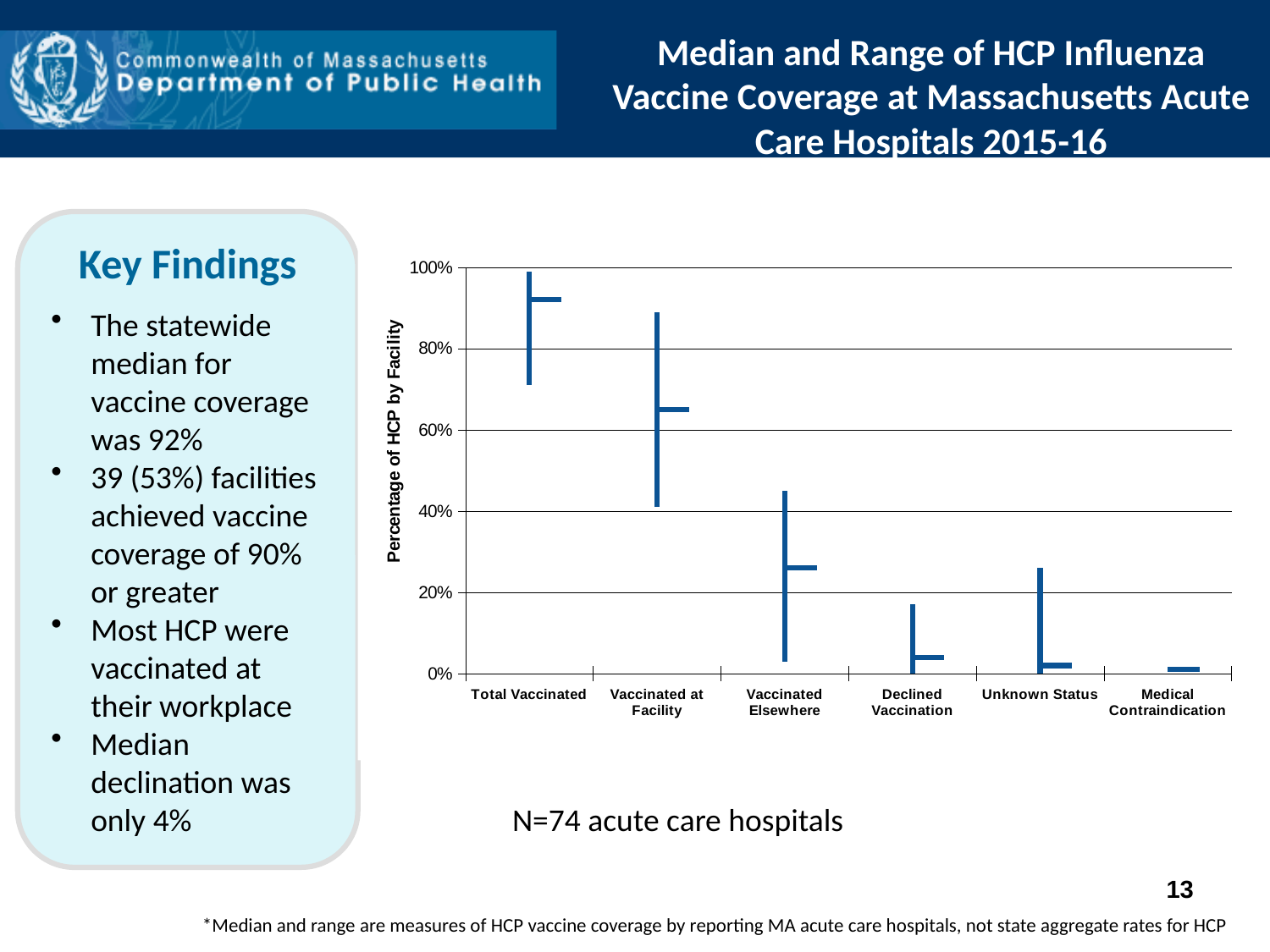
Is the median value for Total Vaccinated greater or less than 80%? greater Is the median value for Declined Vaccination greater or less than 20%? less Do the median values rise or fall moving from left to right across the categories? fall Is the median value for Vaccinated at Facility greater or less than 60%? greater What is the label of the vertical axis of the chart? Percentage of HCP by Facility Which category has the highest median value in the chart? Total Vaccinated Which category has the lowest median value in the chart? Medical Contraindication What is the title of the chart on the slide? Median and Range of HCP Influenza Vaccine Coverage at Massachusetts Acute Care Hospitals 2015-16 How many categories are shown on the x axis of the chart? 6 Which has the larger median value, Vaccinated at Facility or Vaccinated Elsewhere? Vaccinated at Facility